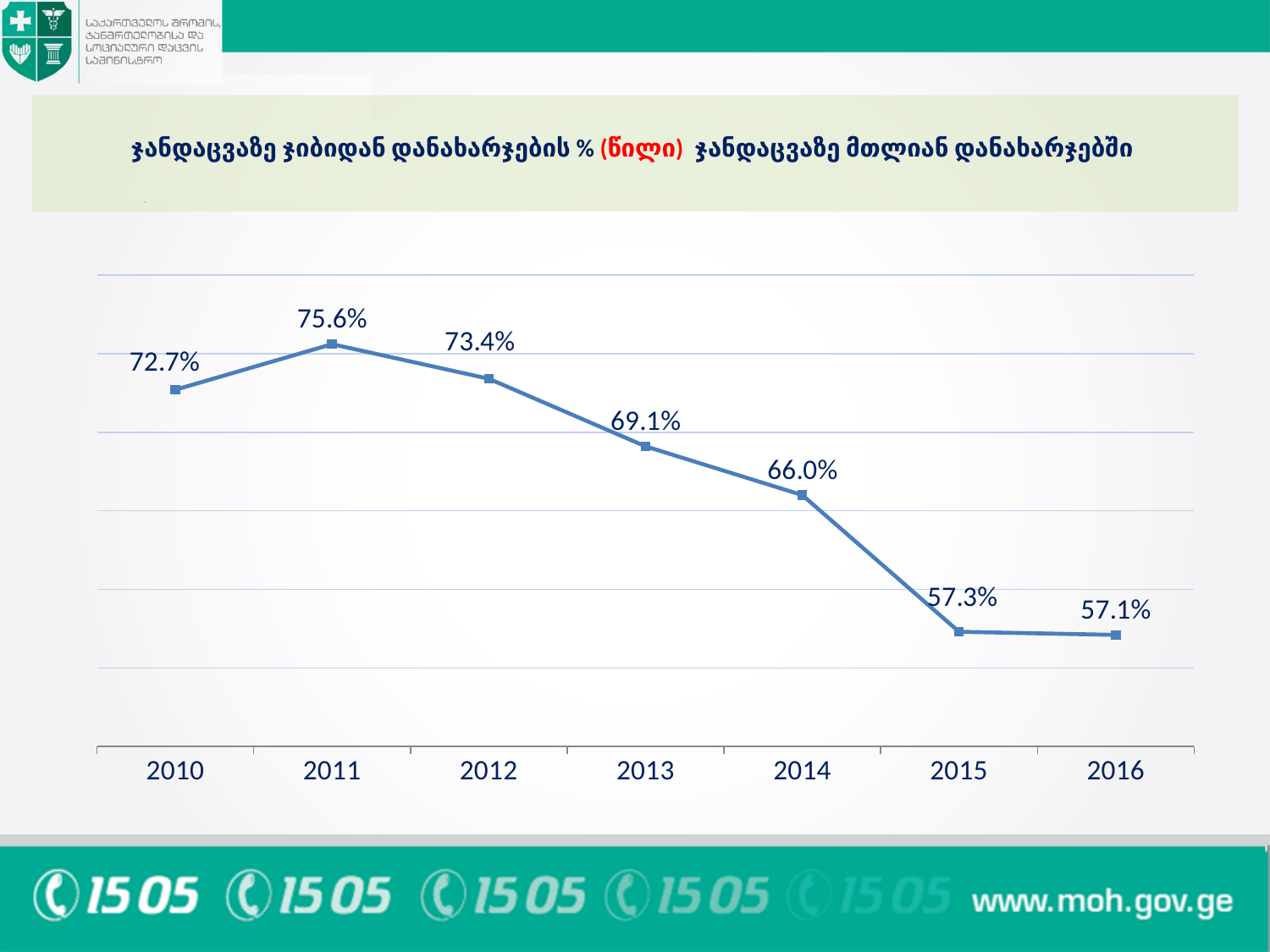
Which year has the highest value? 2011 Which year has the lowest value? 2016 What is the value for 2016? 57.1% What is the value for 2010? 72.7% Which is larger, the value for 2010 or the value for 2013? 2010 How many years are plotted on the chart? 7 What is the value for 2014? 66.0% What colour is the plotted line? Blue What is the difference between the values for 2014 and 2015? 8.7% Do the values rise or fall from 2011 to 2016? Fall What kind of chart is shown on the slide? Line chart What is the difference between the values for 2011 and 2012? 2.2%